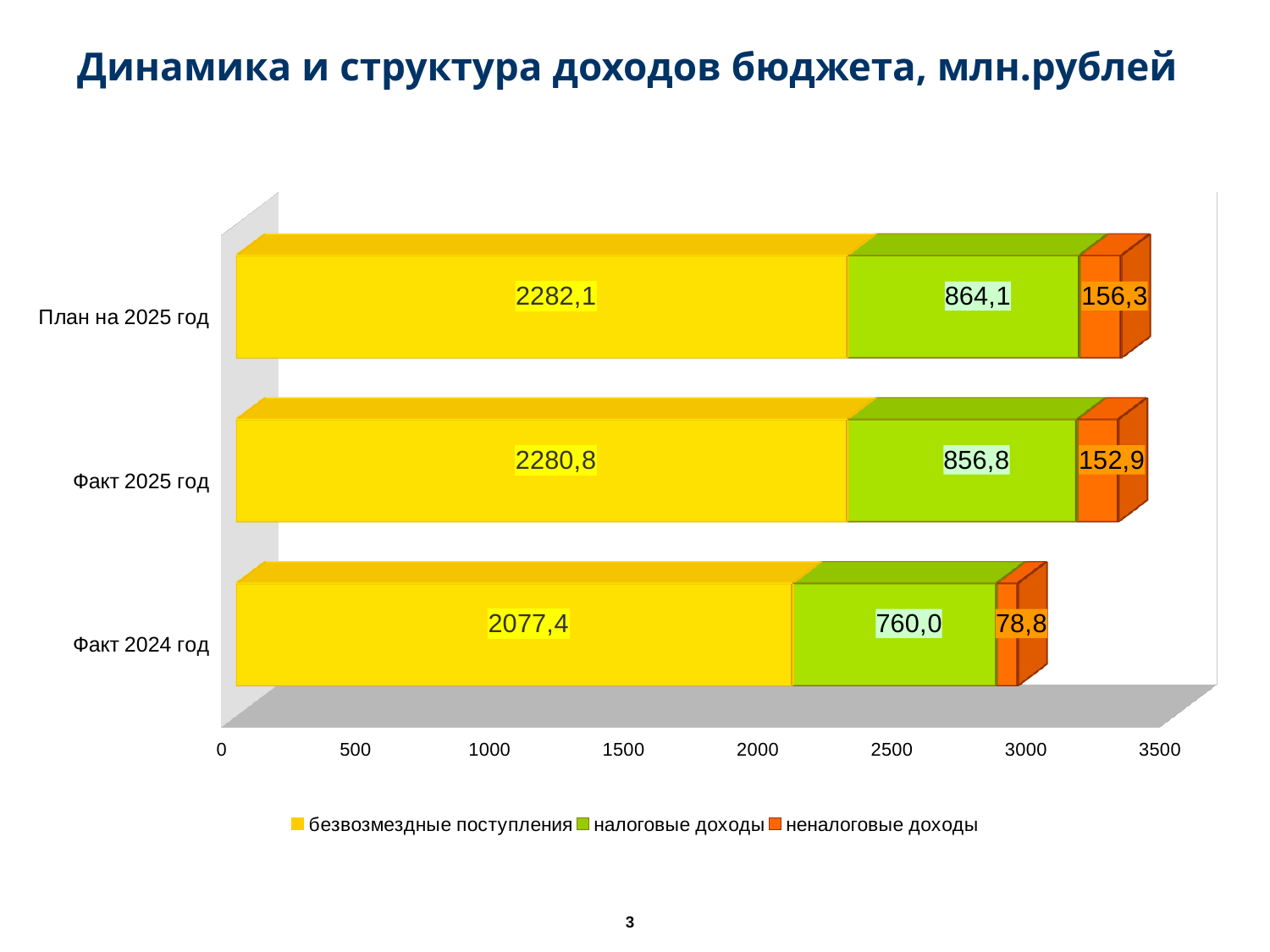
How many categories are shown on the chart? 3 What is the total of the stacked bar for Факт 2024 год? 2916,2 What is the value of безвозмездные поступления for План на 2025 год? 2282,1 Which category has the lowest value for неналоговые доходы? Факт 2024 год What is the difference between налоговые доходы for План на 2025 год and Факт 2024 год? 104,1 What is the difference between неналоговые доходы for План на 2025 год and Факт 2024 год? 77,5 Which is larger: безвозмездные поступления for Факт 2025 год or for Факт 2024 год? Факт 2025 год What kind of chart is shown on the slide? Stacked bar chart How many series does the legend list? 3 What is the value of налоговые доходы for Факт 2024 год? 760,0 Which category has the highest value for налоговые доходы? План на 2025 год What is the value of неналоговые доходы for Факт 2025 год? 152,9